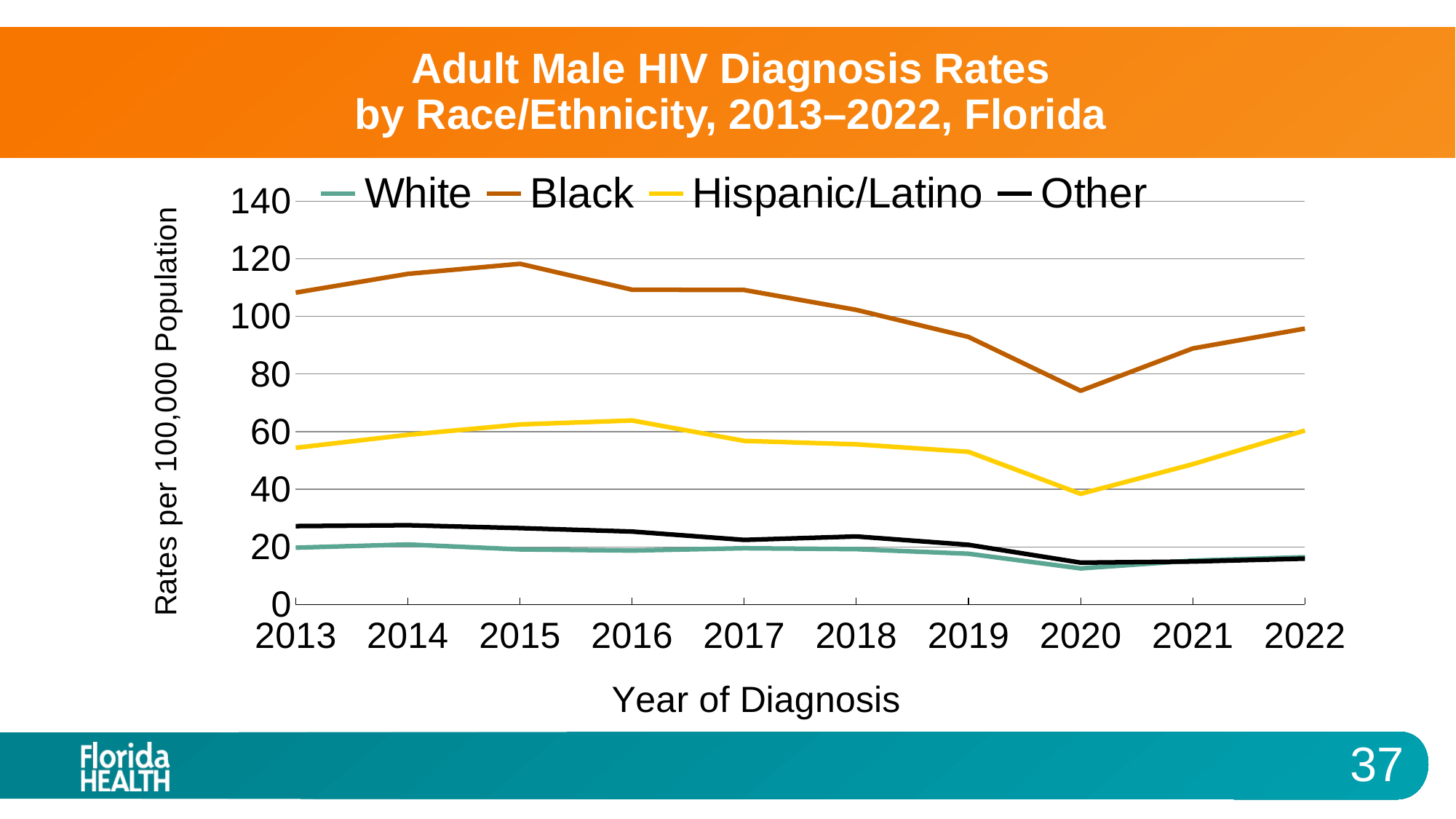
How many series does the legend list? 4 Which race/ethnicity has the highest diagnosis rate in 2015? Black Is the value for Other in 2013 greater or less than 20? greater What kind of chart is shown on the slide? line chart How many years are shown along the x axis? 10 Which is larger, the Black rate in 2013 or the Black rate in 2022? 2013 Is the value for Black in 2020 greater or less than 80? less Does the Black rate rise or fall from 2015 to 2020? fall Which race/ethnicity has the lowest diagnosis rate in 2013? White Is the value for Black in 2015 greater or less than 100? greater In which year is the rate for Black adult males lowest? 2020 What is the y-axis title of the chart? Rates per 100,000 Population